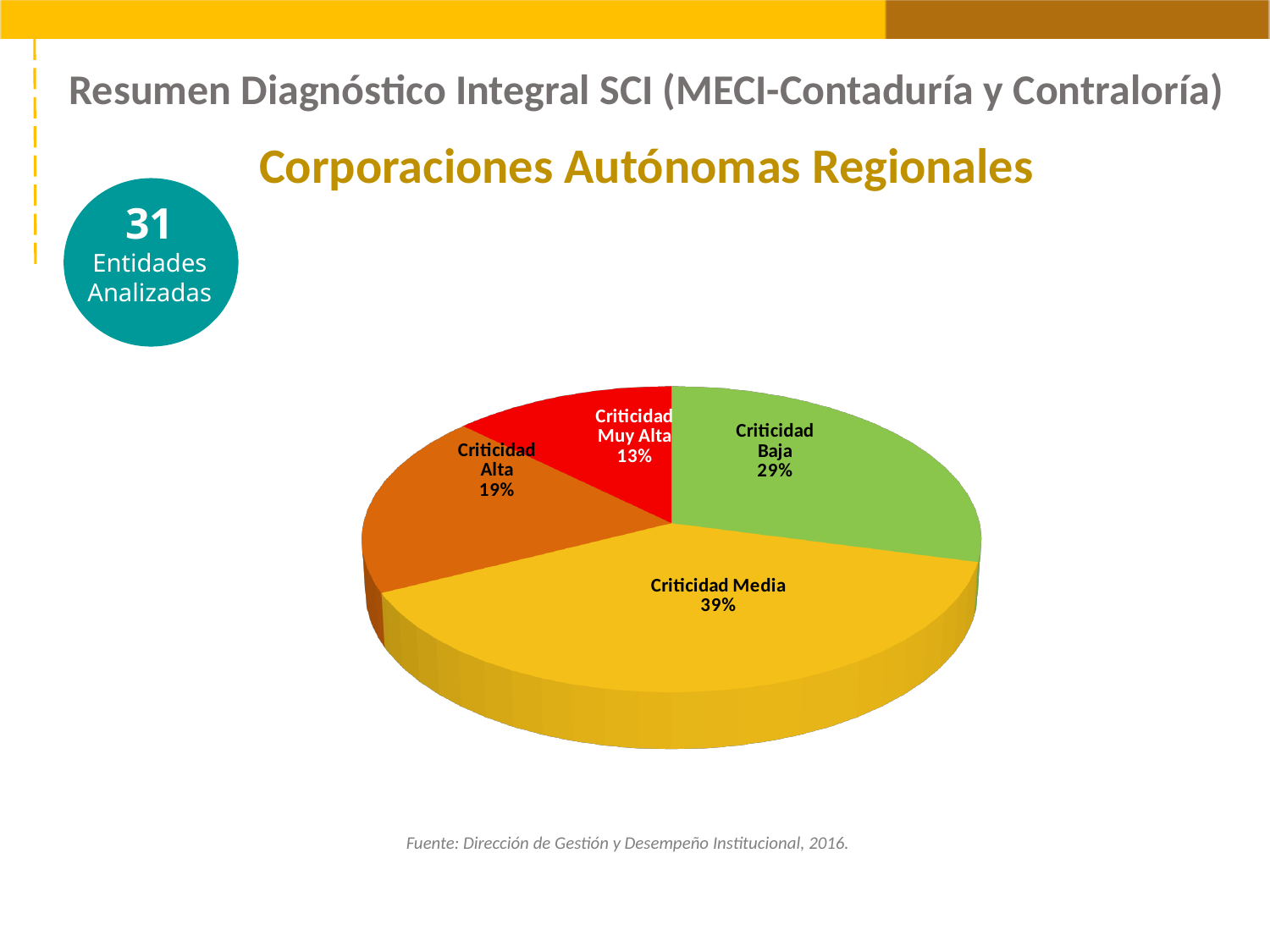
What is the value shown for Criticidad Baja? 29% Which is larger, the share for Criticidad Alta or Criticidad Muy Alta? Criticidad Alta How many categories are shown in the pie chart? 4 Which category has the smallest slice of the pie? Criticidad Muy Alta What share of the pie does Criticidad Media represent? 39% What is the value shown for Criticidad Alta? 19% What kind of chart is shown on the slide? Pie chart Which category has the largest slice of the pie? Criticidad Media What is the difference between the shares of Criticidad Alta and Criticidad Muy Alta? 6% What is the difference between the shares of Criticidad Media and Criticidad Baja? 10% What is the value shown for Criticidad Muy Alta? 13% What colour is the Criticidad Baja slice? Green